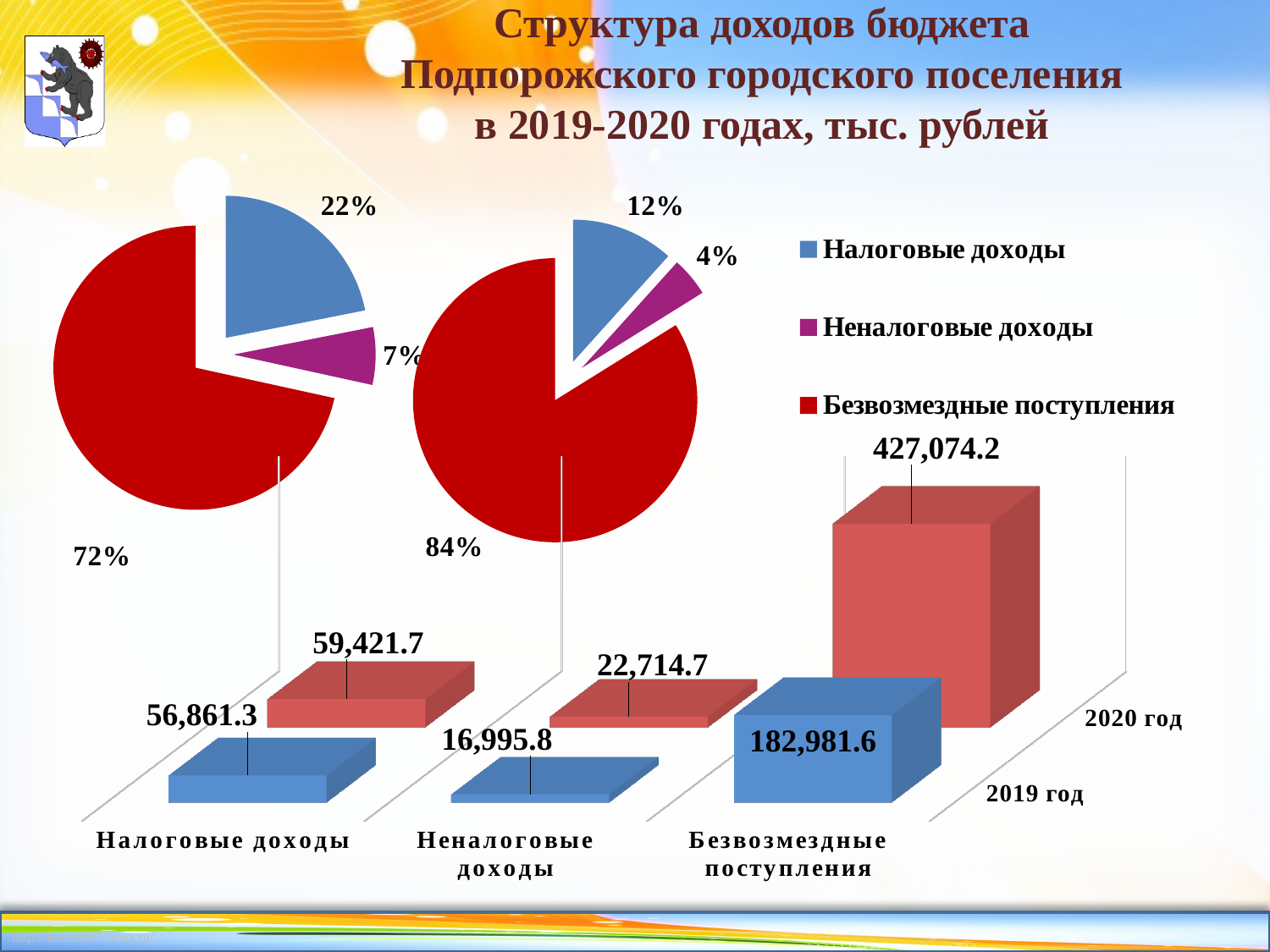
In the right pie chart, which category has the smallest slice? Неналоговые доходы In the bar chart, what is the value for Неналоговые доходы in 2019 год? 16,995.8 How many categories are shown on the x axis of the bar chart? 3 In the bar chart, which category has the lowest value in 2020 год? Неналоговые доходы In the right pie chart, what share is shown for Налоговые доходы? 12% In the bar chart, what is the difference between the 2020 год and 2019 год values for Безвозмездные поступления? 244,092.6 In the left pie chart, what share is shown for Безвозмездные поступления? 72% In the bar chart, which category has the highest value in 2019 год? Безвозмездные поступления What kind of chart is the left chart on the slide? Pie chart In the bar chart, what is the difference between the 2020 год and 2019 год values for Налоговые доходы? 2,560.4 In the bar chart, is the value for Неналоговые доходы larger in 2019 год or 2020 год? 2020 год In the bar chart, what is the value for Безвозмездные поступления in 2020 год? 427,074.2